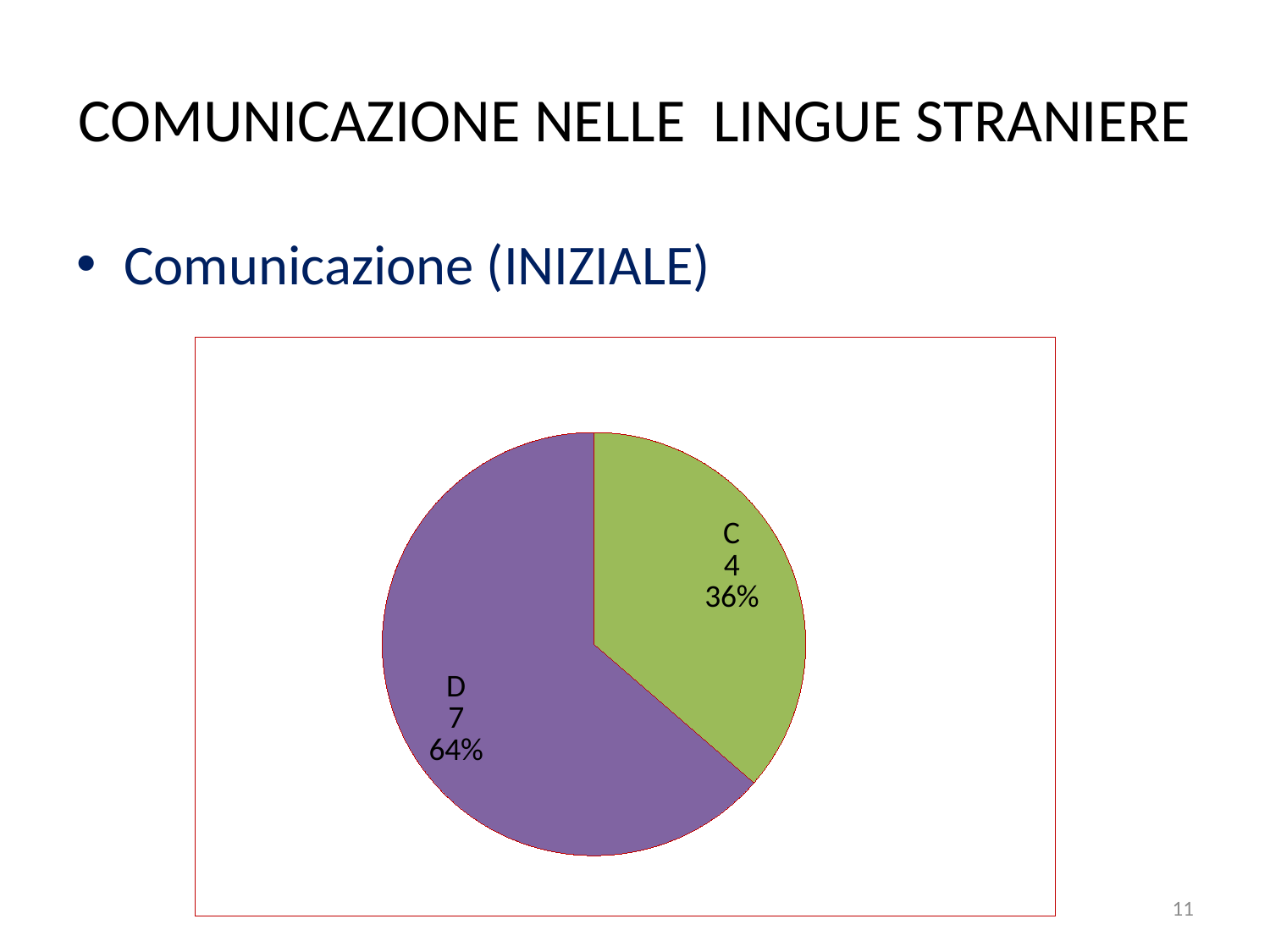
Which category has the smallest slice? C What share of the pie does slice D represent? 64% What is the value for category D? 7 Which is larger, the value for C or the value for D? D What is the value for category C? 4 What is the total of the values shown in the pie chart? 11 What colour is the slice for category C? green Which category has the largest slice? D What is the difference between the values for D and C? 3 What share of the pie does slice C represent? 36% How many slices does the pie chart have? 2 What kind of chart is shown on the slide? pie chart